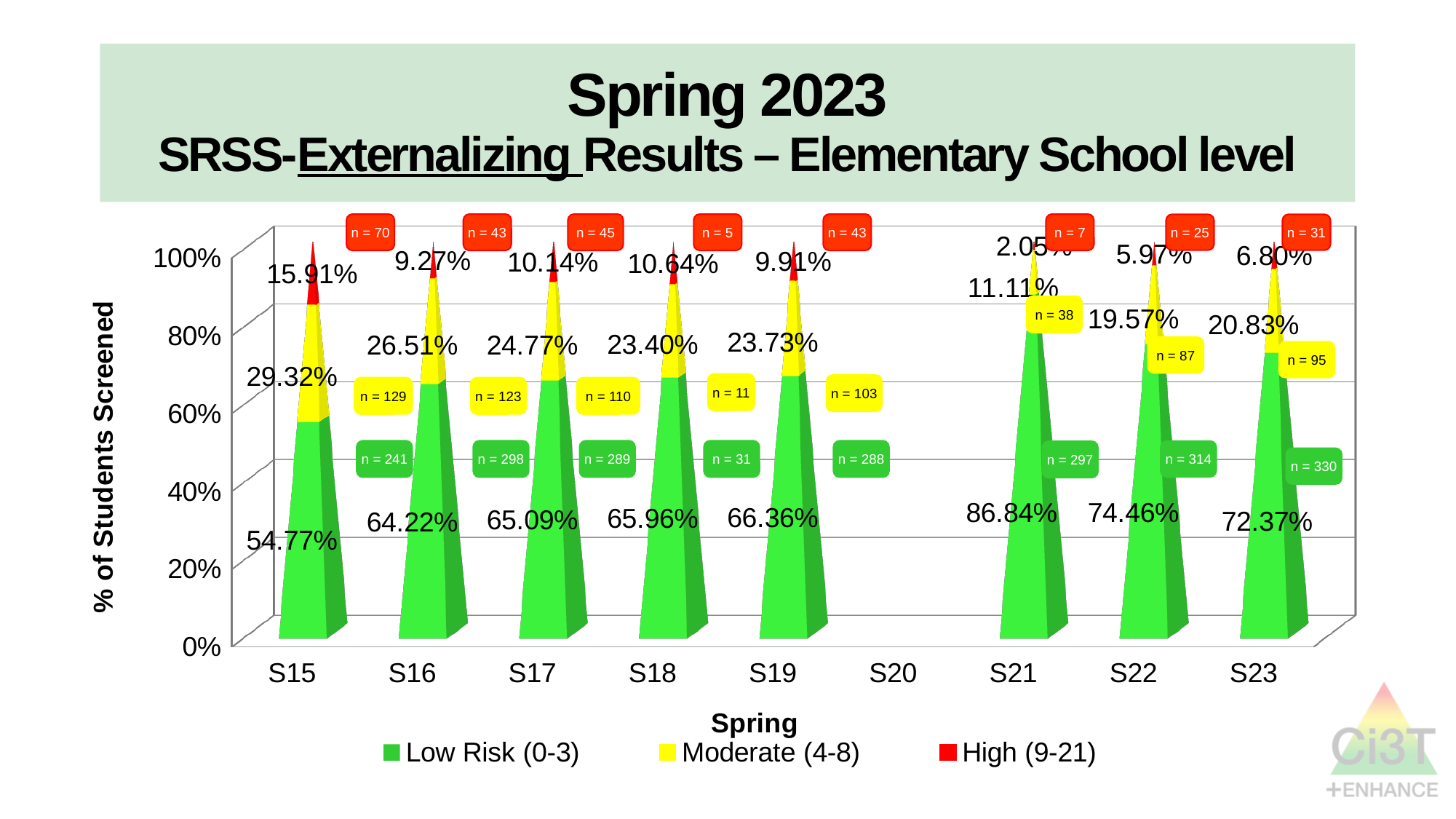
What is the difference in percentage points between the Low Risk (0-3) value in S21 and in S15? 32.07 How many series does the legend list? 3 How many spring labels are shown on the x axis? 9 Does the Low Risk (0-3) percentage rise or fall from S15 to S19? Rise What is the n value shown for the Moderate (4-8) group in S23? n = 95 What is the title of the y axis? % of Students Screened What kind of chart is shown on the slide? Stacked bar chart Which spring has the lowest Low Risk (0-3) percentage? S15 What percentage of students screened were Low Risk (0-3) in S15? 54.77% Which spring has the highest Low Risk (0-3) percentage? S21 What percentage of students screened were High (9-21) in S21? 2.05% Which is larger, the High (9-21) percentage in S16 or in S17? S17